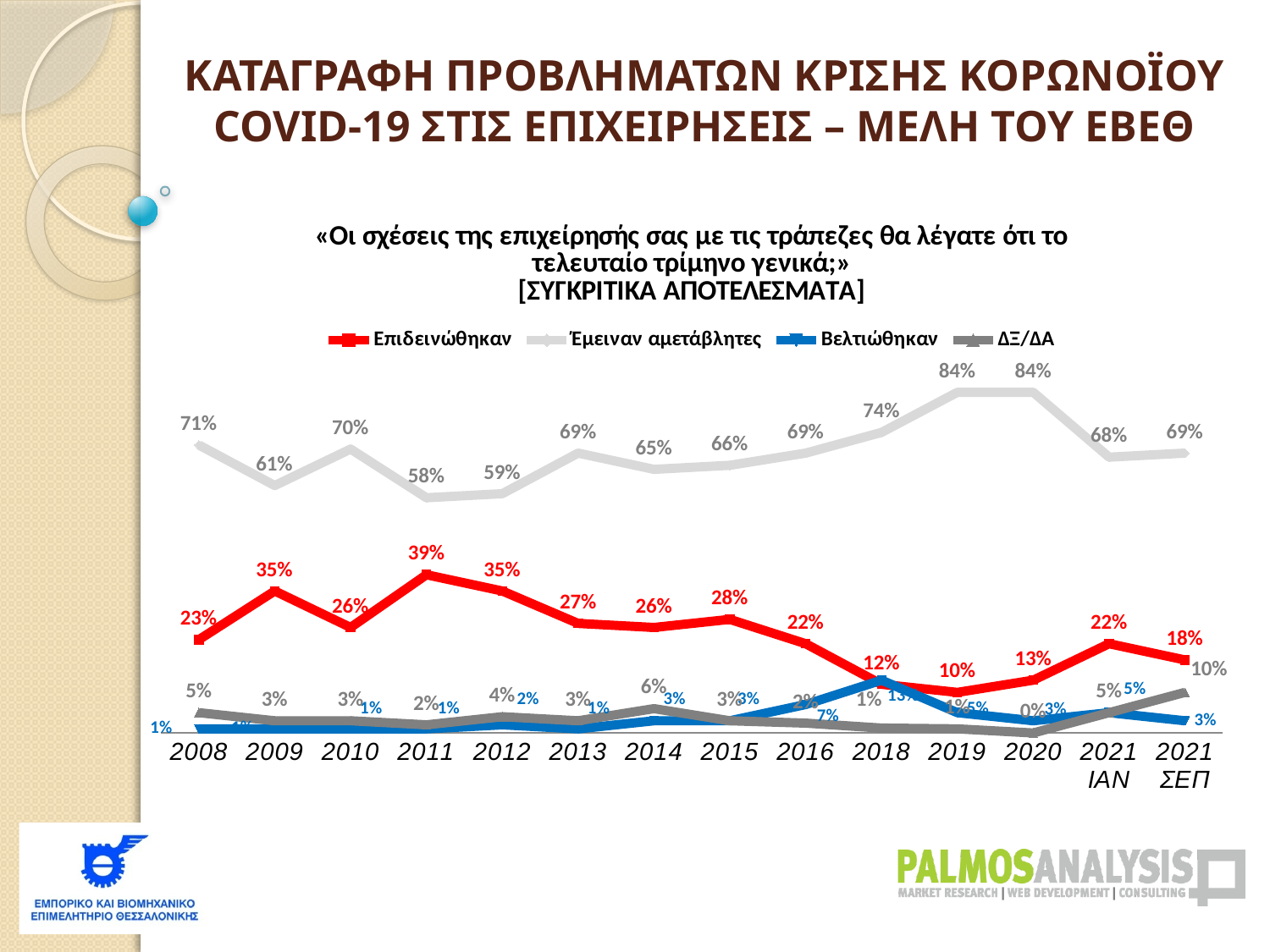
In which year does the Επιδεινώθηκαν series reach its lowest value? 2019 In which year does the Έμειναν αμετάβλητες series reach its lowest value? 2011 What is the value of the Βελτιώθηκαν series in 2016? 7% What kind of chart is shown on the slide? Line chart What is the value of the ΔΞ/ΔΑ series in 2021 ΣΕΠ? 10% In which year does the Επιδεινώθηκαν series reach its highest value? 2011 Which is larger for the Επιδεινώθηκαν series: the value in 2009 or the value in 2013? 2009 How many series does the legend list? 4 By how many percentage points does the Έμειναν αμετάβλητες series fall from 2020 to 2021 ΙΑΝ? 16 percentage points How many time points are shown on the x axis? 14 What is the value of the Επιδεινώθηκαν series in 2011? 39% What is the value of the Έμειναν αμετάβλητες series in 2018? 74%